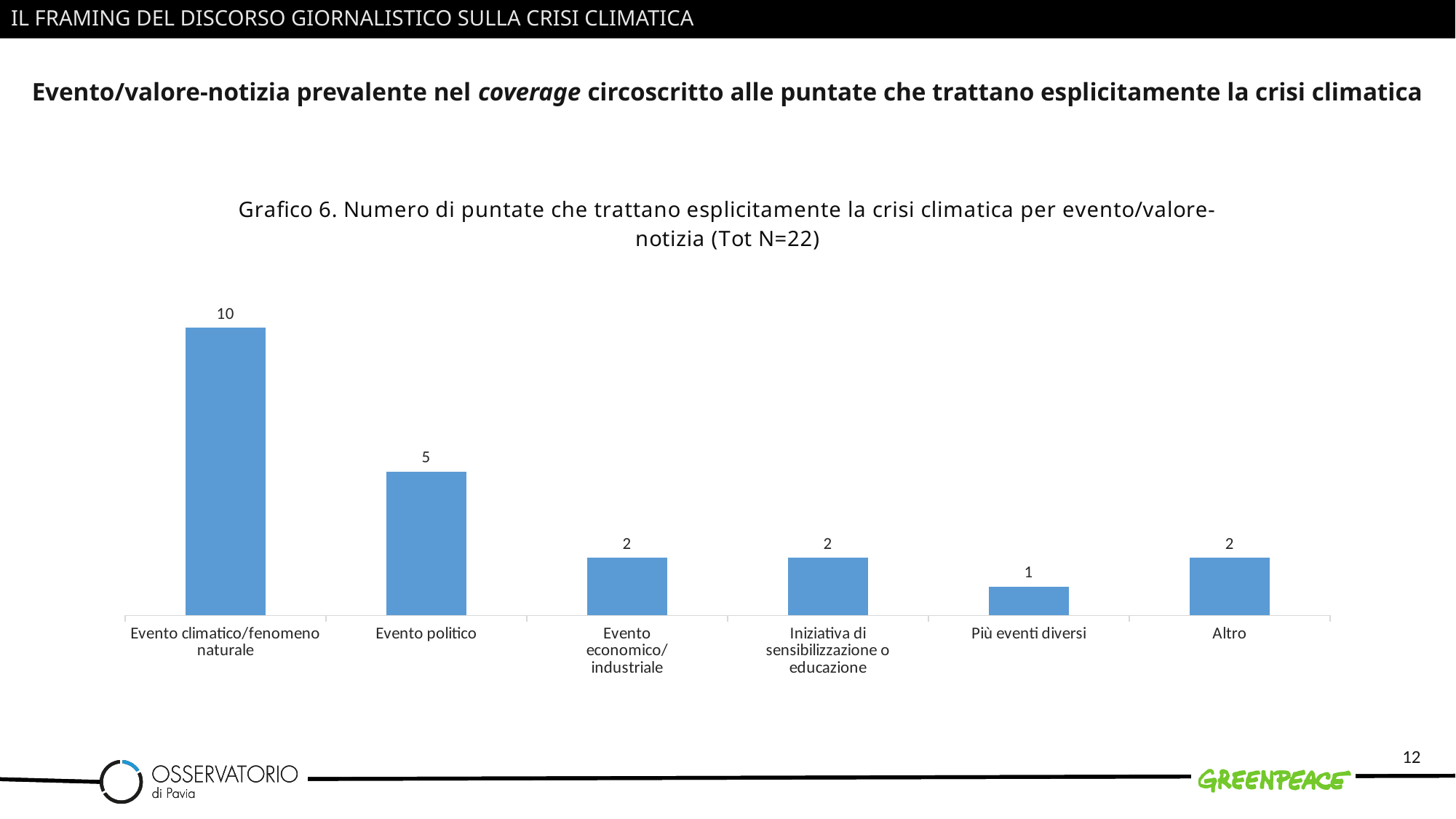
What is the value for Evento politico? 5 What is the difference between the values for Evento climatico/fenomeno naturale and Evento politico? 5 What is the value for Più eventi diversi? 1 What is the difference between the values for Evento economico/industriale and Più eventi diversi? 1 What is the value for Altro? 2 How many categories are shown on the x axis? 6 What kind of chart is shown on the slide? Bar chart What is the value for Evento climatico/fenomeno naturale? 10 Which category has the highest value? Evento climatico/fenomeno naturale Which category has the lowest value? Più eventi diversi Which is larger, the value for Evento politico or the value for Altro? Evento politico What is the total N stated in the chart title? 22